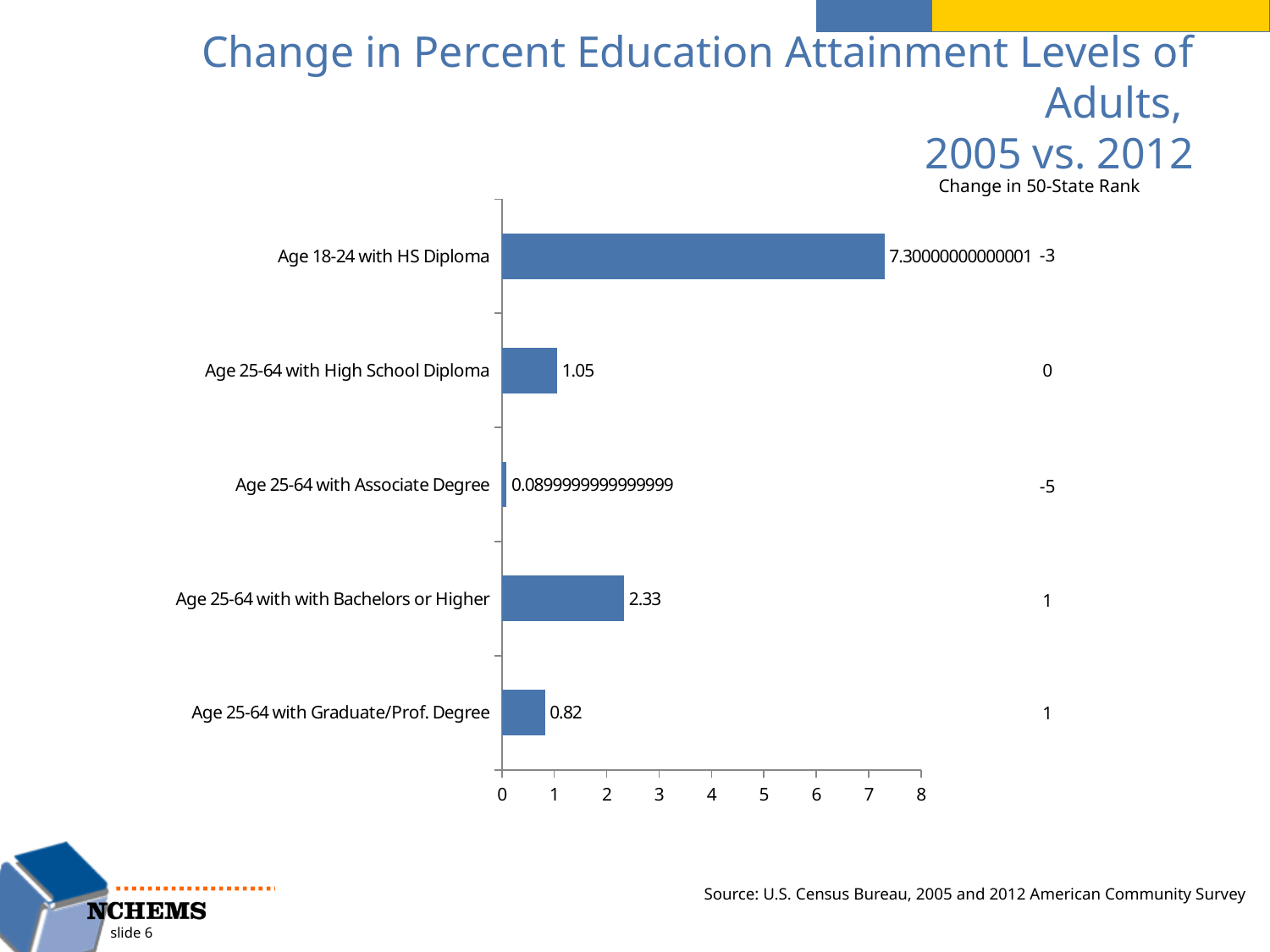
What is the difference between the values for Age 25-64 with High School Diploma and Age 25-64 with Graduate/Prof. Degree? 0.23 What is the data label shown for Age 18-24 with HS Diploma? 7.30000000000001 What is the value for Age 25-64 with with Bachelors or Higher? 2.33 What is the value for Age 25-64 with High School Diploma? 1.05 Is the value for Age 18-24 with HS Diploma greater or less than 7? greater What kind of chart is shown on the slide? bar chart What is the difference between the values for Age 25-64 with with Bachelors or Higher and Age 25-64 with High School Diploma? 1.28 Which is larger, the value for Age 25-64 with with Bachelors or Higher or the value for Age 25-64 with High School Diploma? Age 25-64 with with Bachelors or Higher Which category has the lowest value? Age 25-64 with Associate Degree Which category has the highest value? Age 18-24 with HS Diploma What is the value for Age 25-64 with Graduate/Prof. Degree? 0.82 How many categories are shown in the chart? 5